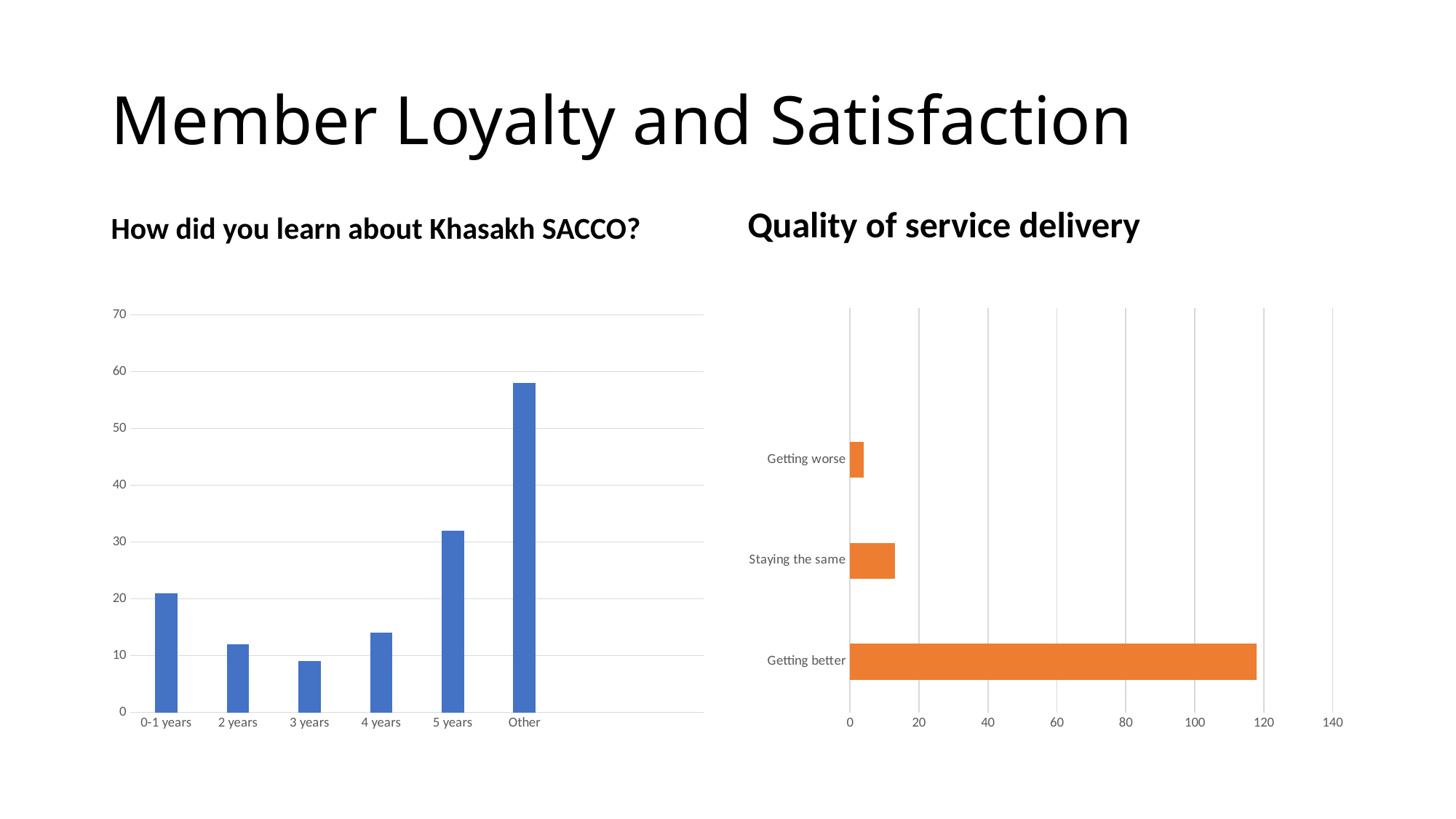
In the 'How did you learn about Khasakh SACCO?' chart, how many categories are shown on the x axis? 6 In the 'Quality of service delivery' chart, which category has the shortest bar? Getting worse In the 'How did you learn about Khasakh SACCO?' chart, which category has the lowest bar? 3 years In the 'How did you learn about Khasakh SACCO?' chart, which is larger: the value for 0-1 years or the value for 2 years? 0-1 years In the 'How did you learn about Khasakh SACCO?' chart, is the value for 5 years greater or less than 30? greater What kind of chart is the 'Quality of service delivery' chart? bar chart In the 'Quality of service delivery' chart, is the value for Getting better greater or less than 100? greater In the 'Quality of service delivery' chart, how many categories are shown? 3 What is the title of the chart on the right side of the slide? Quality of service delivery In the 'Quality of service delivery' chart, which category has the longest bar? Getting better What kind of chart is the 'How did you learn about Khasakh SACCO?' chart? bar chart In the 'How did you learn about Khasakh SACCO?' chart, which category has the highest bar? Other